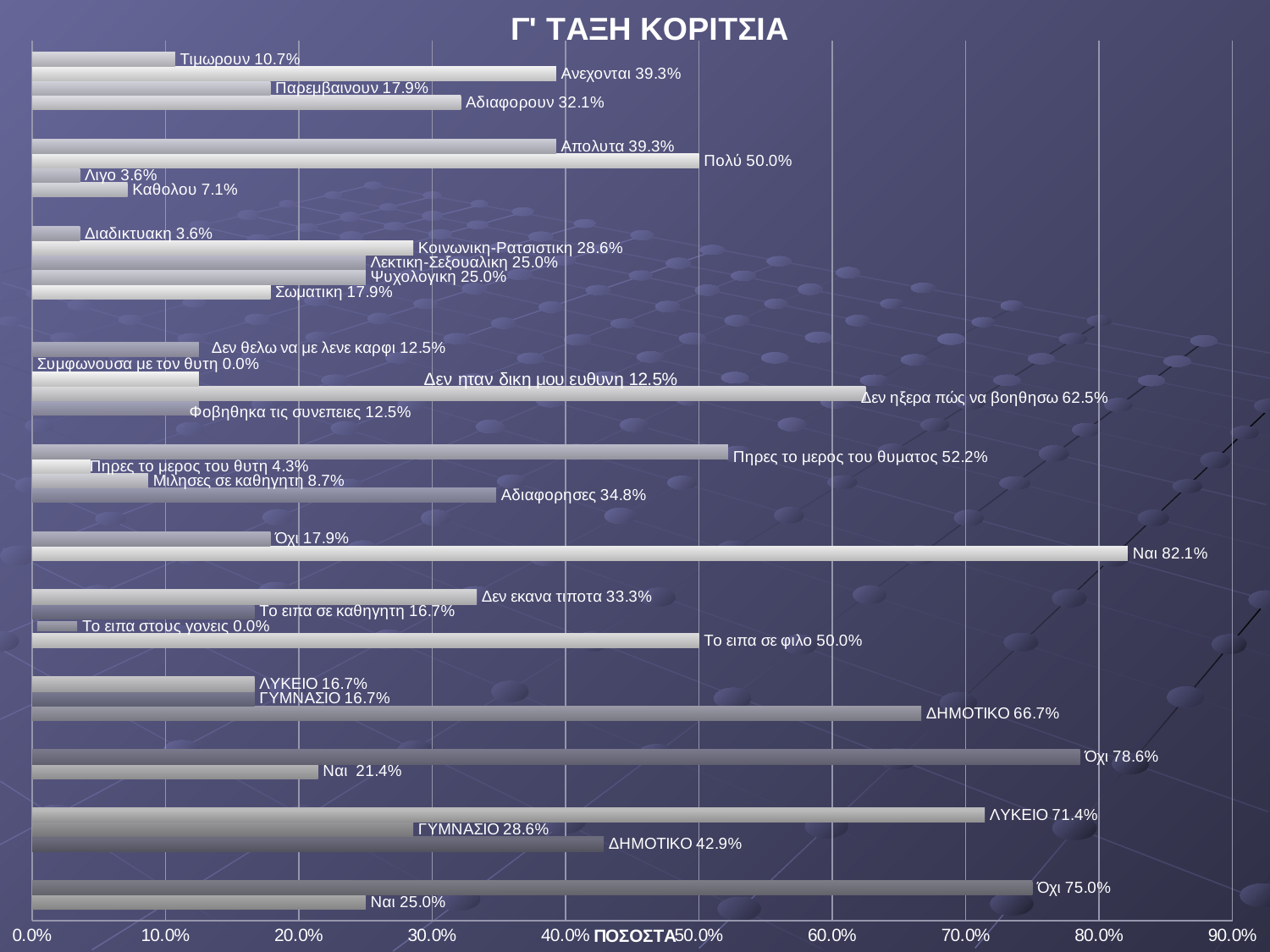
What is the value shown for Διαδικτυακη? 3.6% What is the value shown for Ανεχονται? 39.3% What is the title of the chart? Γ' ΤΑΞΗ ΚΟΡΙΤΣΙΑ What is the value shown for Δεν ηξερα πώς να βοηθησω? 62.5% Which is larger, the value for Κοινωνικη-Ρατσιστικη or the value for Σωματικη? Κοινωνικη-Ρατσιστικη Is the value for Αδιαφορησες greater or less than 30.0%? greater What is the value shown for Πηρες το μερος του θυματος? 52.2% What is the difference between the values for Πολύ and Απολυτα? 10.7 percentage points How many bars are in the group that contains Σωματικη, Ψυχολογικη and Διαδικτυακη? 5 What is the title of the horizontal axis? ΠΟΣΟΣΤΑ What kind of chart is shown on the slide? bar chart Which bar has the highest value on the whole chart? Ναι (82.1%)